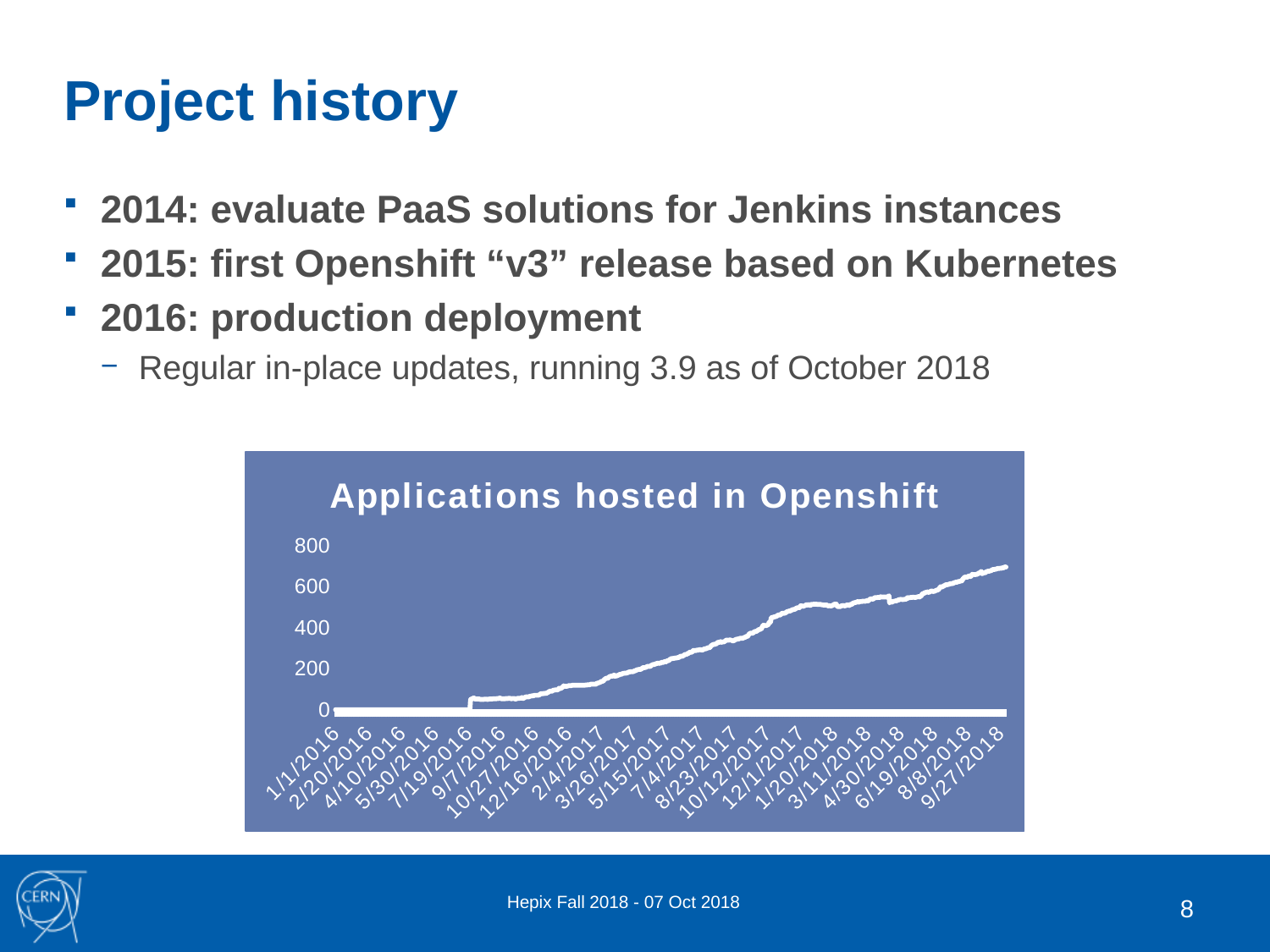
What is the first date label on the x axis? 1/1/2016 Which is larger, the value at 1/1/2016 or the value at 9/27/2018? 9/27/2018 Is the value at 9/27/2018 greater or less than 600? greater What is the title of the chart? Applications hosted in Openshift How many date labels are shown on the x axis? 21 Is the value at 3/26/2017 greater or less than 400? less What kind of chart is shown on the slide? line chart Is the value at 1/20/2018 greater or less than 400? greater Do the values in the chart rise or fall from left to right along the x axis? rise What is the highest tick value shown on the y axis? 800